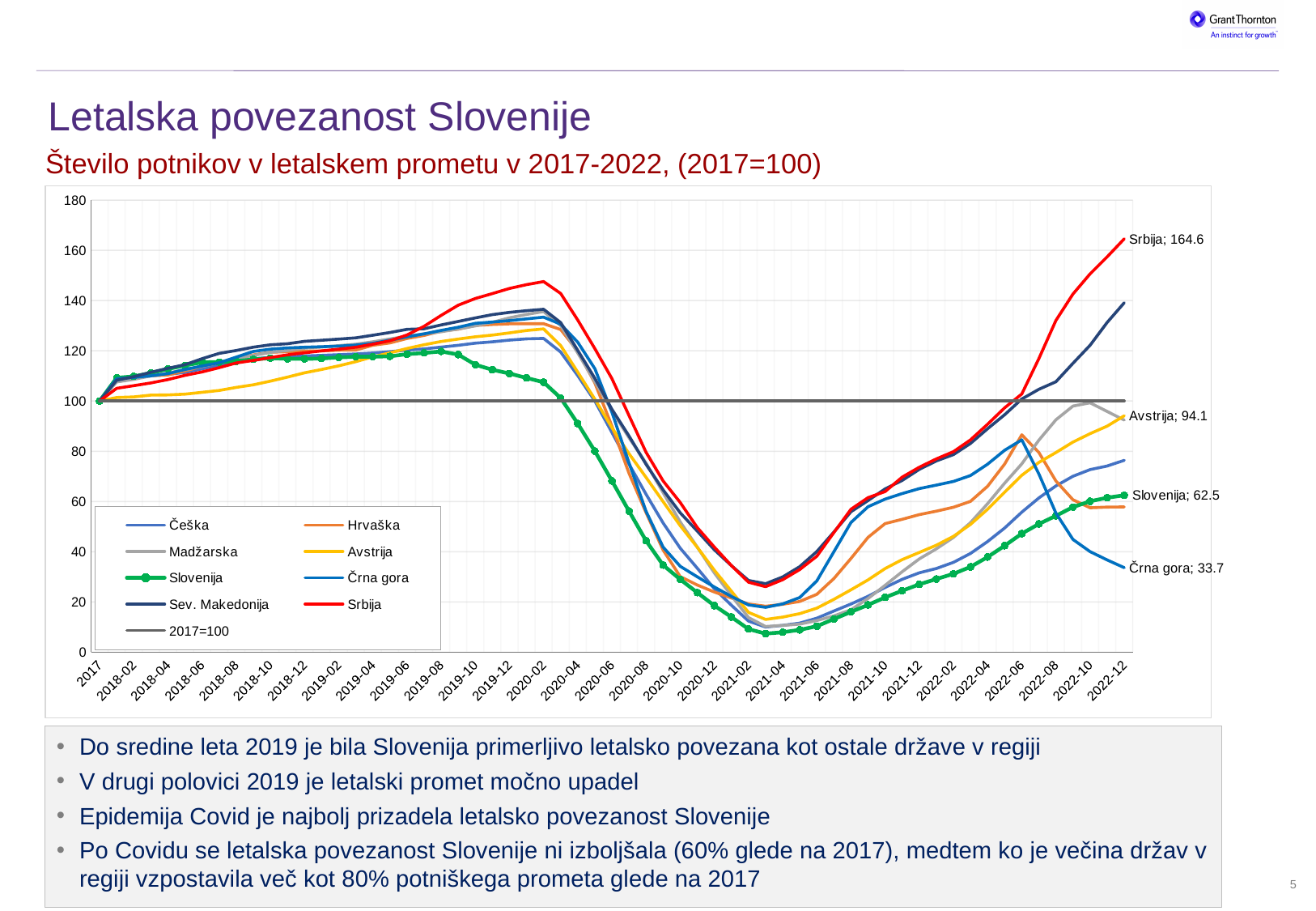
At the end of the series, which is larger: the value for Avstrija or the value for Slovenija? Avstrija Is the value for Slovenija around 2021-04 greater or less than 20? less What is the value labelled for Črna gora at the end of the series (2022-12)? 33.7 What is the value labelled for Slovenija at the end of the series (2022-12)? 62.5 How many entries does the chart legend list? 9 What is the difference between the labelled end values of Avstrija and Črna gora? 60.4 Which series has the lowest value at the end of the chart (2022-12)? Črna gora What is the value labelled for Avstrija at the end of the series (2022-12)? 94.1 What kind of chart is shown on the slide? Line chart Which series has the highest value at the end of the chart (2022-12)? Srbija What is the value labelled for Srbija at the end of the series (2022-12)? 164.6 What is the difference between the labelled end values of Srbija and Slovenija? 102.1